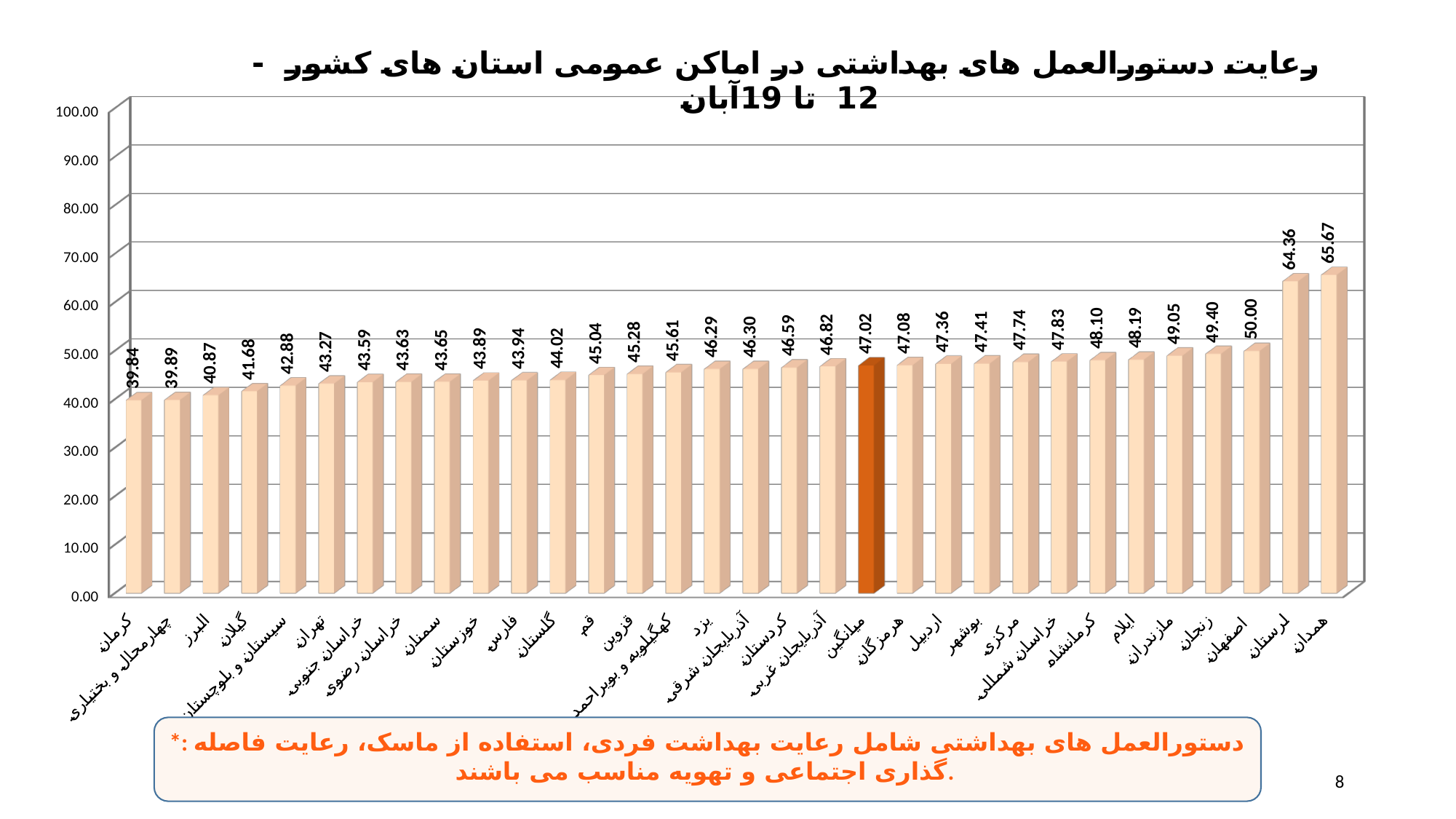
Do the values generally rise or fall from left to right along the x axis? rise Which category has the lowest value? کرمان Which category has the highest value? همدان What is the value for the highlighted bar میانگین? 47.02 What is the difference between the values for همدان and لرستان? 1.31 What is the value for تهران? 43.27 What type of chart is shown on the slide? bar chart Is the value for کرمان greater or less than 40.00? less What is the value for همدان? 65.67 How many bars are plotted in the chart? 32 Which has a larger value, لرستان or اصفهان? لرستان What is the value for اصفهان? 50.00